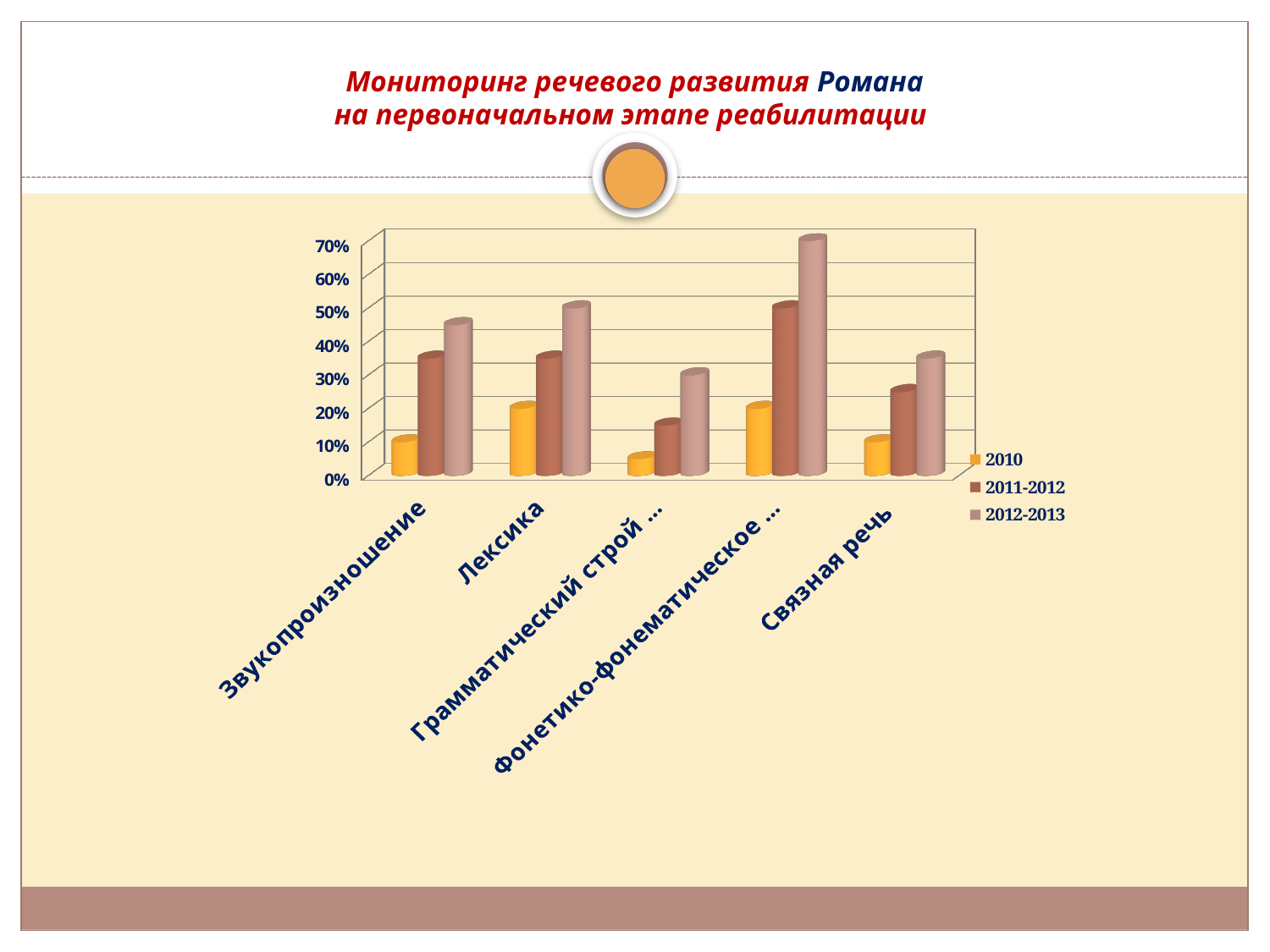
How many series does the chart's legend list? 3 For the 2011-2012 series, which is larger: Фонетико-фонематическое ... or Связная речь? Фонетико-фонематическое ... Which category has the highest value for the 2012-2013 series? Фонетико-фонематическое ... Which series are listed in the chart's legend? 2010, 2011-2012, 2012-2013 Is the 2010 value for Грамматический строй ... greater or less than 10%? less What kind of chart is shown on the slide? bar chart Within each category, do the values rise or fall from the 2010 series to the 2012-2013 series? rise Is the 2012-2013 value for Лексика greater or less than 40%? greater Is the 2010 value for Звукопроизношение greater or less than 20%? less Which category has the lowest value for the 2010 series? Грамматический строй ... How many categories are shown on the x axis of the chart? 5